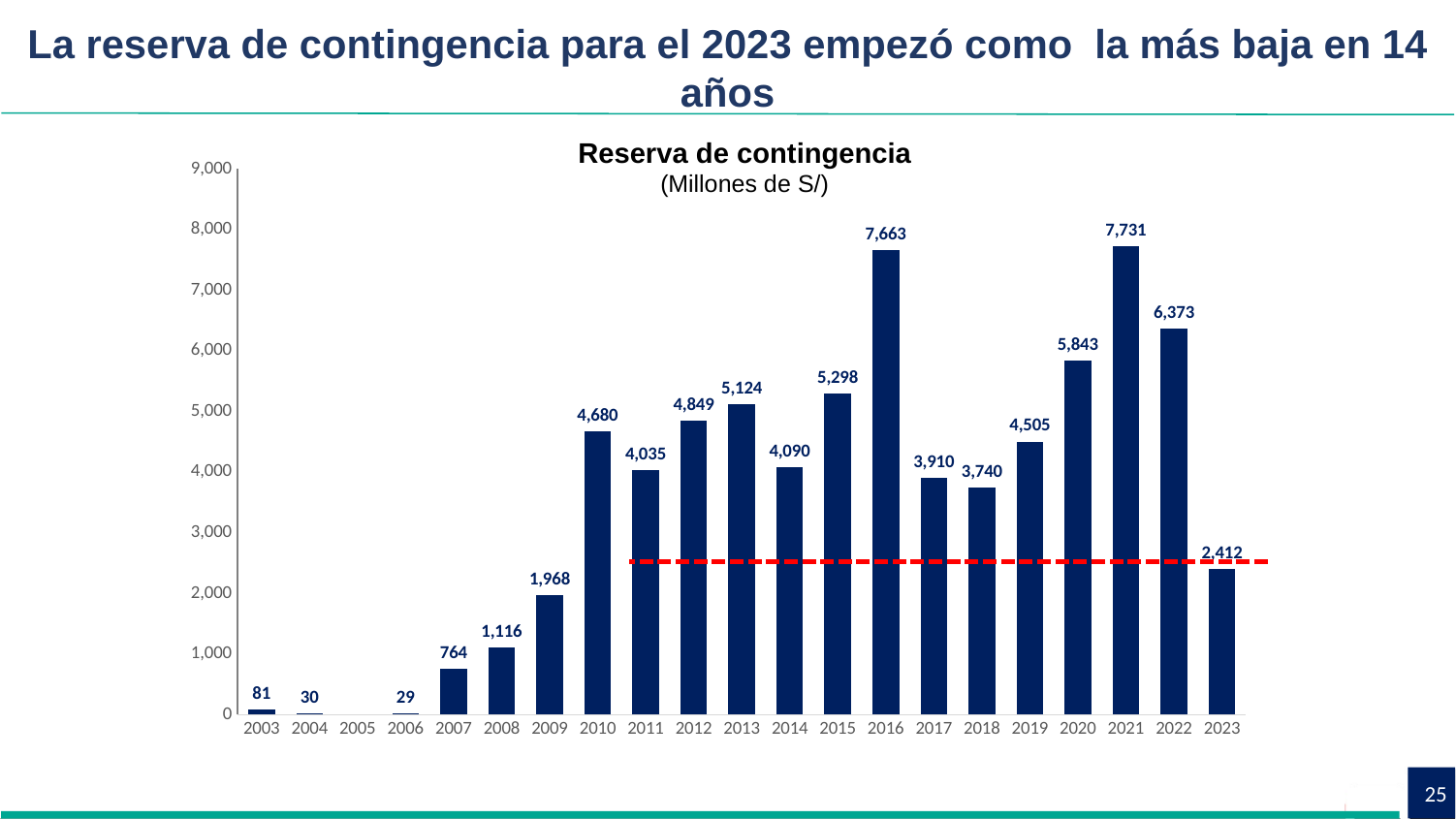
What kind of chart is shown on the slide? Bar chart Do the values rise or fall from 2006 to 2010? Rise What is the difference between the values for 2021 and 2016? 68 What is the value shown for 2008? 1,116 Which year has the highest reserva de contingencia? 2021 How many years are shown on the x axis of the chart? 21 Which is larger, the value for 2013 or the value for 2014? 2013 What is the difference between the values for 2022 and 2023? 3,961 Is the value for 2020 greater or less than 5,000? greater What is the value shown for 2016? 7,663 What unit is given in the chart subtitle? Millones de S/ What is the value of the reserva de contingencia for 2023? 2,412